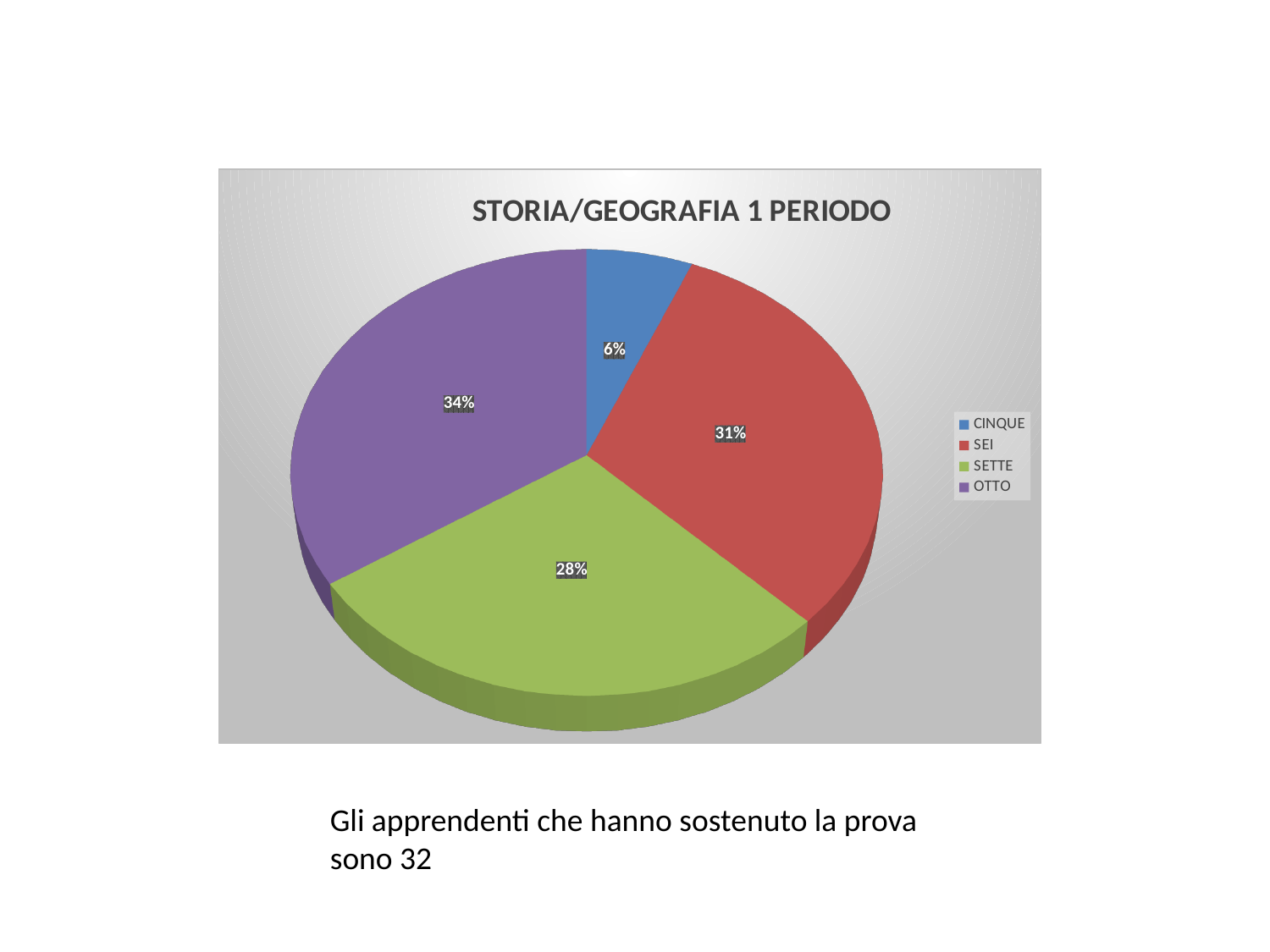
What type of chart is shown on the slide? Pie chart Which category has the largest share of the pie? OTTO How many categories are shown in the pie chart? 4 What is the difference in percentage points between the OTTO slice and the CINQUE slice? 28 What percentage of the pie does the SETTE slice represent? 28% What percentage of the pie does the SEI slice represent? 31% What is the title of the chart? STORIA/GEOGRAFIA 1 PERIODO Which slice is larger, SEI or SETTE? SEI Which colour represents the SETTE category in the legend? Green Which category has the smallest share of the pie? CINQUE What percentage of the pie does the CINQUE slice represent? 6%